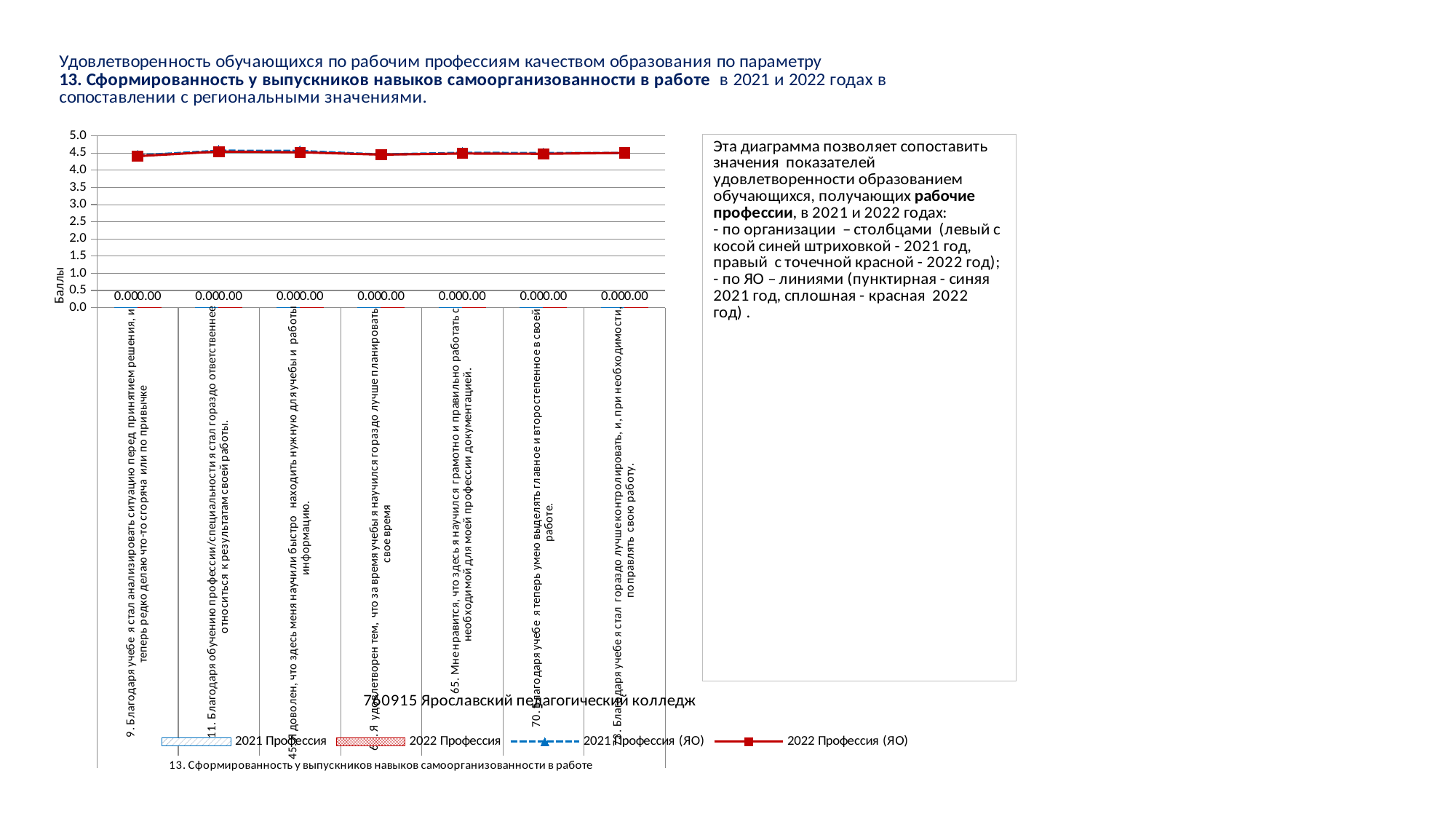
Is the value of the 2022 Профессия (ЯО) line for category 70 greater or less than 3.5? greater Which is larger for the 2022 Профессия (ЯО) line: the value for category 9 or the value for category 11? category 11 How many series does the chart legend list? 4 What colour is the 2022 Профессия (ЯО) line in the chart? Red What value is printed as the data label for the 2021 Профессия bar at category 9? 0.00 Is the value of the 2022 Профессия (ЯО) line for category 9 greater or less than 4.0? greater Is the value of the 2021 Профессия (ЯО) line for category 65 greater or less than 5.0? less What kind of chart is shown on the slide? Combined bar and line chart How many categories (questions) are shown along the x axis of the chart? 7 What is the title of the vertical axis of the chart? Баллы